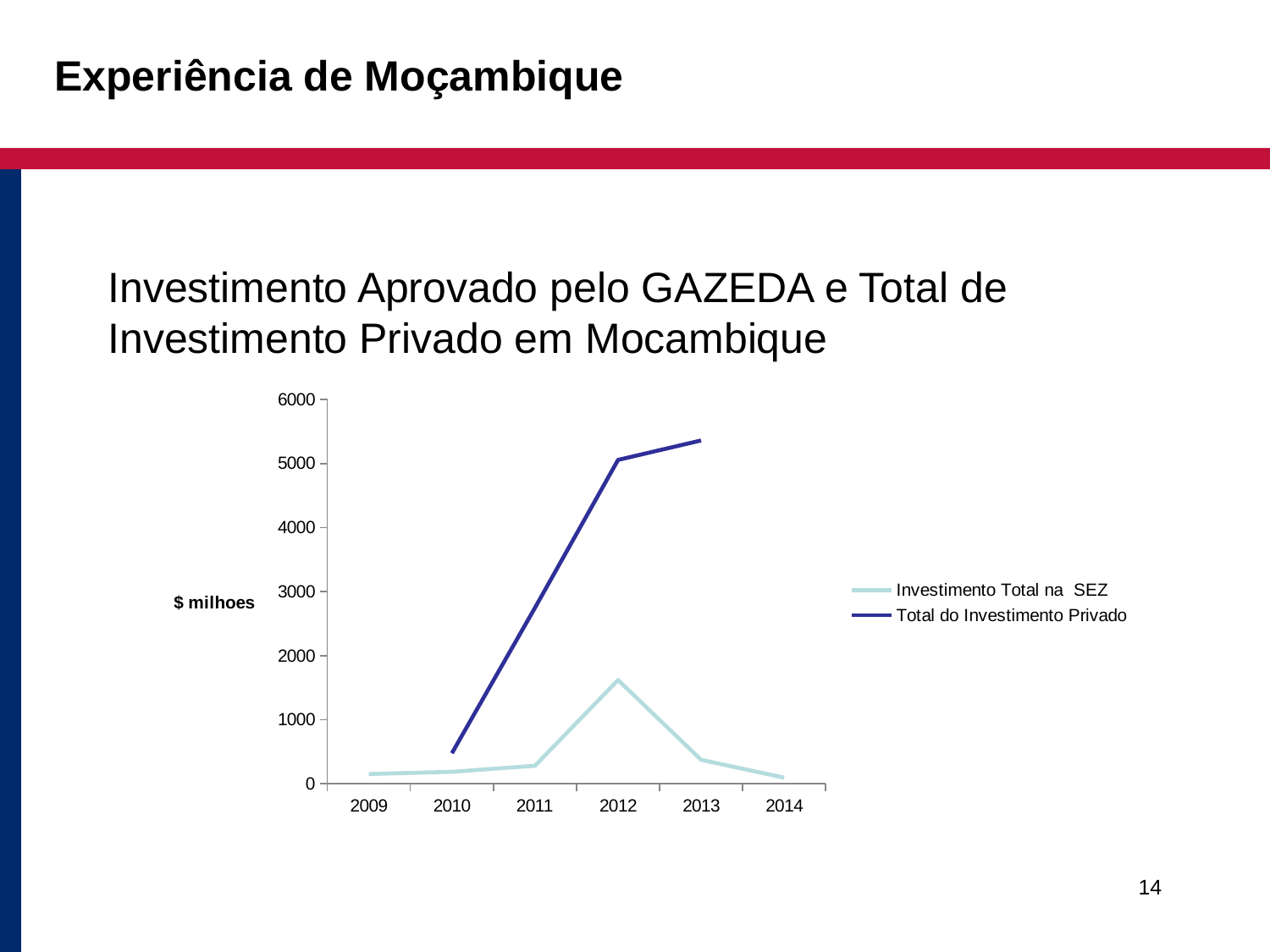
Is the value for Investimento Total na SEZ in 2012 greater or less than 1000? greater In which year is the Investimento Total na SEZ series at its lowest value? 2014 Is the value for Total do Investimento Privado in 2013 greater or less than 5000? greater Does the Total do Investimento Privado series rise or fall from 2010 to 2013? rise What kind of chart is shown on the slide? line chart What is the label on the vertical axis of the chart? $ milhoes Is the value for Total do Investimento Privado in 2010 greater or less than 1000? less In which year does the Investimento Total na SEZ series reach its highest value? 2012 How many years are shown on the x axis? 6 In which year does the Total do Investimento Privado series reach its highest value? 2013 In 2012, which series has the larger value, Investimento Total na SEZ or Total do Investimento Privado? Total do Investimento Privado How many series does the legend list? 2